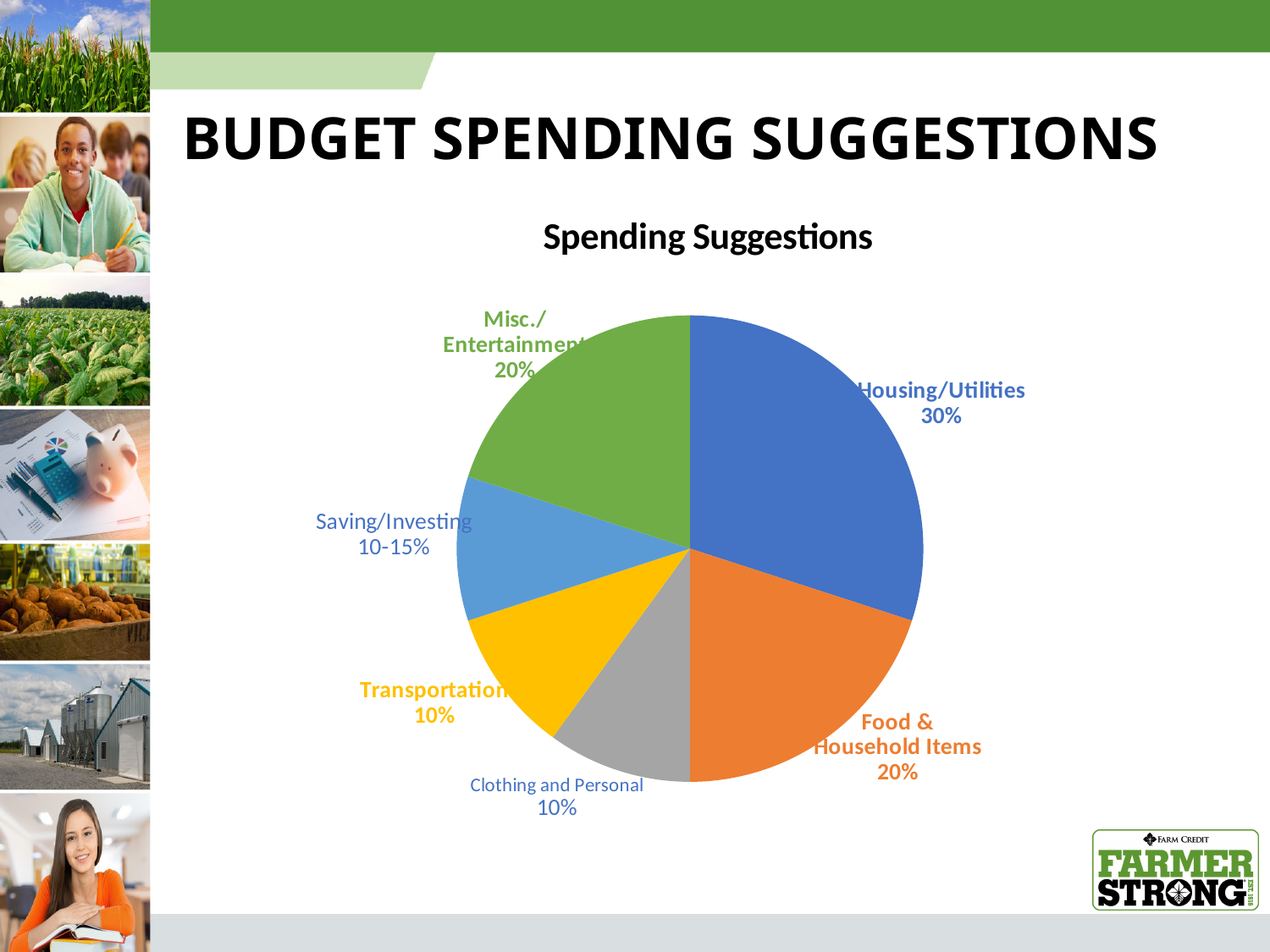
Which category has the largest share of the pie? Housing/Utilities What is the difference in percentage points between Housing/Utilities and Food & Household Items? 10 What percentage is suggested for Food & Household Items? 20% What percentage is suggested for Clothing and Personal? 10% What percentage is suggested for Saving/Investing? 10-15% What type of chart is shown on the slide? pie chart What is the title of the chart? Spending Suggestions How many slices does the pie chart have? 6 What percentage is suggested for Housing/Utilities? 30% What colour is the Misc./Entertainment slice? green What percentage is suggested for Transportation? 10% Which is larger, the share for Housing/Utilities or the share for Misc./Entertainment? Housing/Utilities